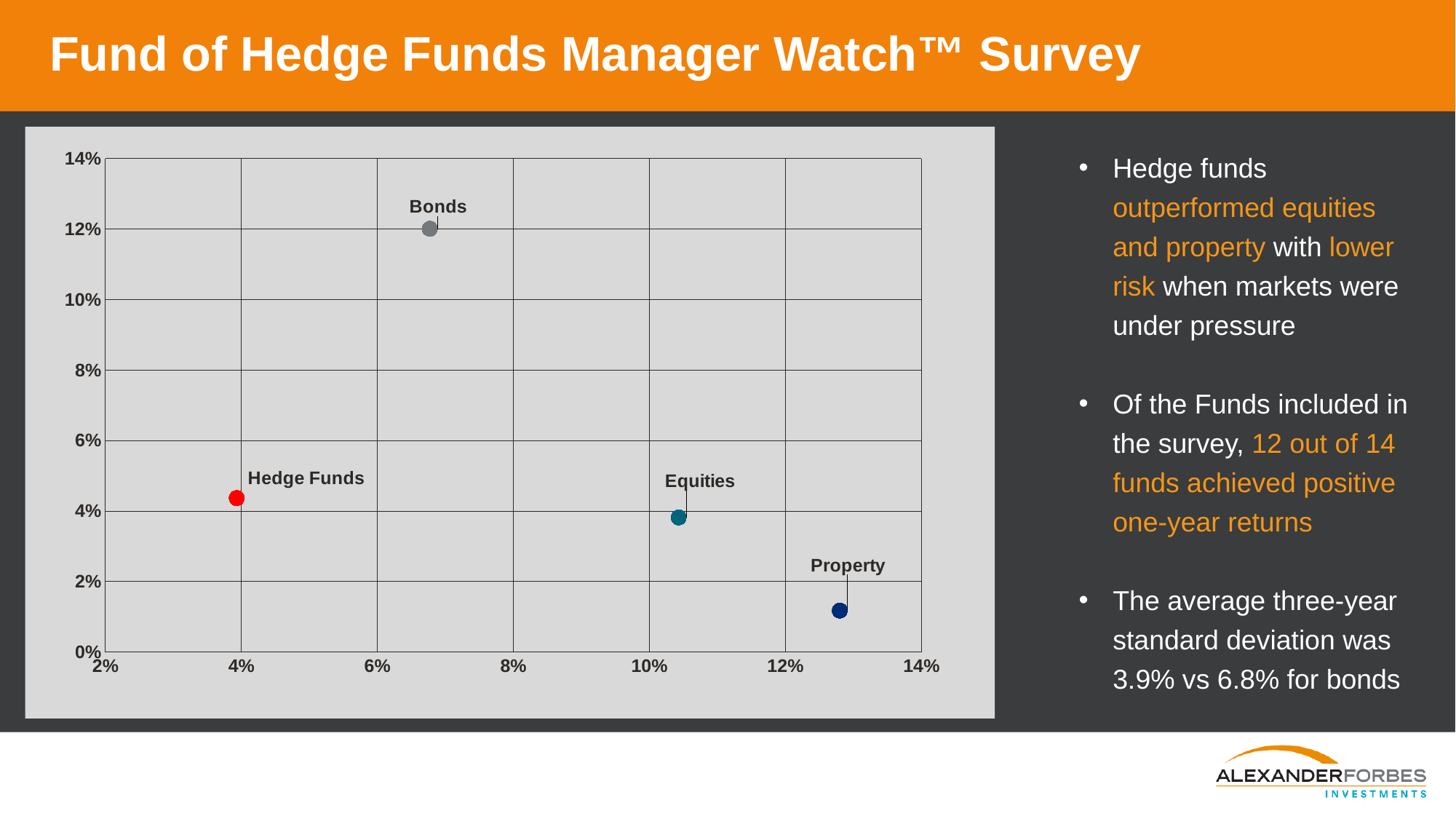
What kind of chart is shown on the slide? Scatter chart Is the vertical-axis value for Bonds greater or less than 10%? greater What colour is the Hedge Funds point on the chart? Red Which point is plotted highest on the vertical axis? Bonds Which is plotted higher on the vertical axis, Hedge Funds or Equities? Hedge Funds Which point is furthest to the right on the horizontal axis? Property Which point is plotted lowest on the vertical axis? Property Which is plotted further right on the horizontal axis, Bonds or Equities? Equities How many data points are plotted on the chart? 4 Which point is furthest to the left on the horizontal axis? Hedge Funds Is the vertical-axis value for Property greater or less than 2%? less Is the horizontal-axis value for Equities greater or less than 10%? greater